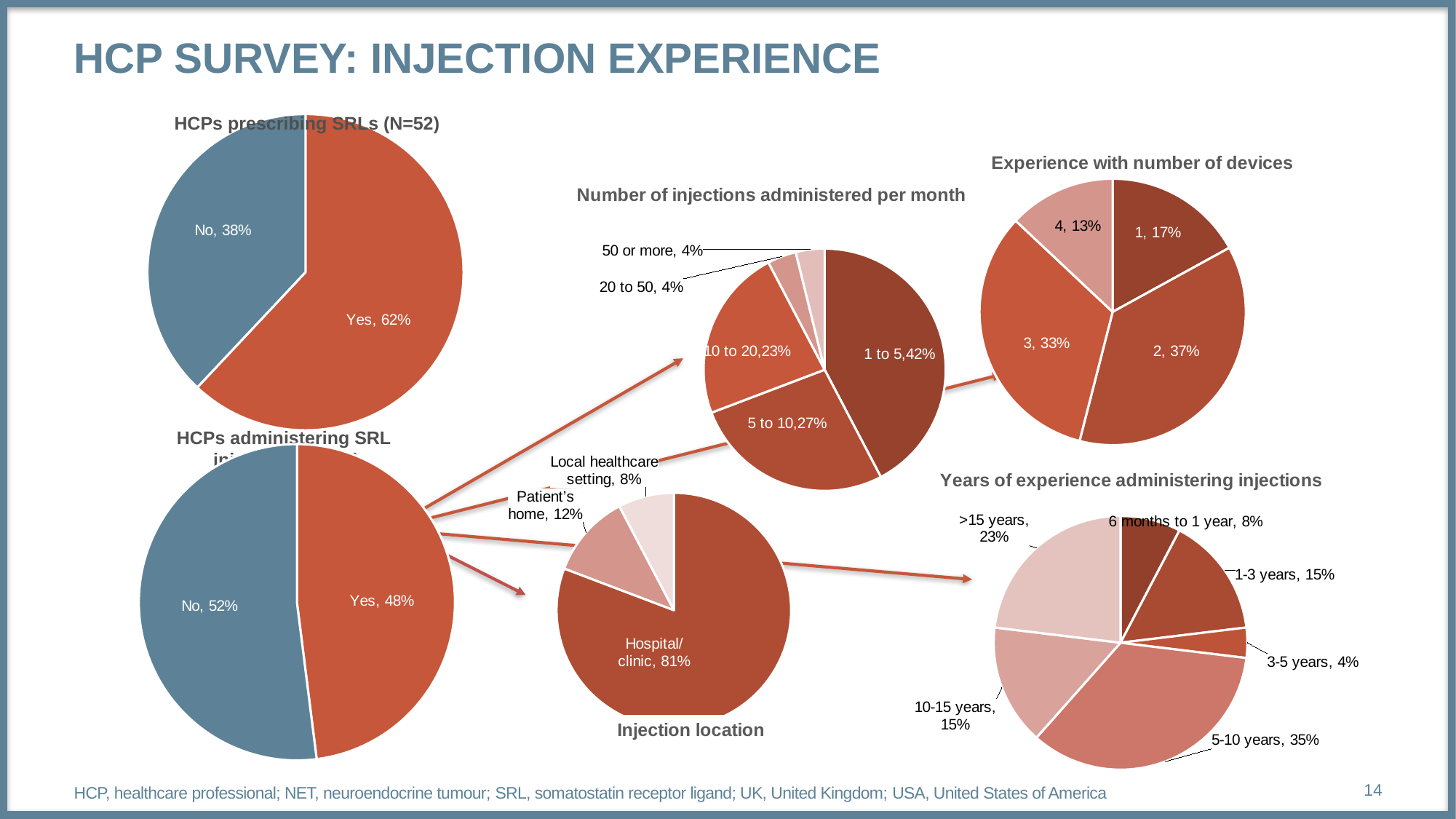
In the 'Experience with number of devices' chart, what is the difference between the shares for 2 devices and 3 devices? 4% In the 'Number of injections administered per month' chart, what is the share for 5 to 10 injections? 27% In the 'Experience with number of devices' chart, what is the share for 2 devices? 37% In the 'Injection location' chart, what is the share for Hospital/clinic? 81% In the 'HCPs prescribing SRLs (N=52)' chart, what share of HCPs answered No? 38% In the 'Years of experience administering injections' chart, which category has the largest share? 5-10 years In the 'Number of injections administered per month' chart, which category has the largest share? 1 to 5 How many categories are shown in the 'Number of injections administered per month' chart? 5 In the 'Experience with number of devices' chart, which category has the smallest share? 4 What type of chart is used for 'Years of experience administering injections'? Pie chart In the 'HCPs prescribing SRLs (N=52)' chart, what share of HCPs answered Yes? 62% In the 'Injection location' chart, which is larger: Patient's home or Local healthcare setting? Patient's home